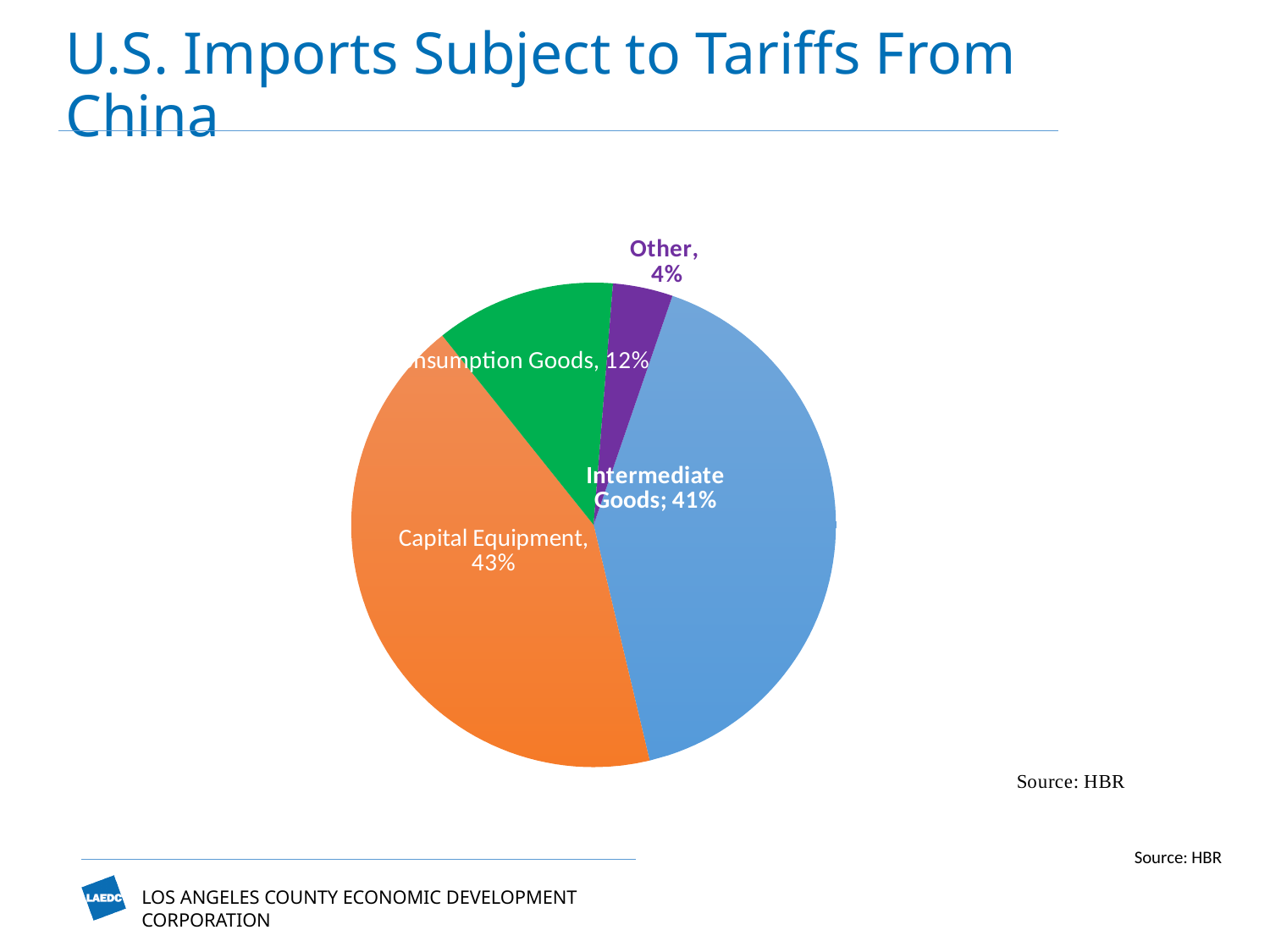
What colour is the Intermediate Goods slice? Blue What kind of chart is shown on the slide? Pie chart Which category has the smallest share of the pie? Other What share of the pie is Intermediate Goods? 41% What share of the pie is Other? 4% What share of the pie is Consumption Goods? 12% What is the difference in percentage points between Capital Equipment and Intermediate Goods? 2 percentage points What is the title of the chart slide? U.S. Imports Subject to Tariffs From China Which is larger, the share for Consumption Goods or the share for Other? Consumption Goods What share of U.S. imports subject to tariffs from China is Capital Equipment? 43% How many slices does the pie chart have? 4 Which category has the largest share of the pie? Capital Equipment